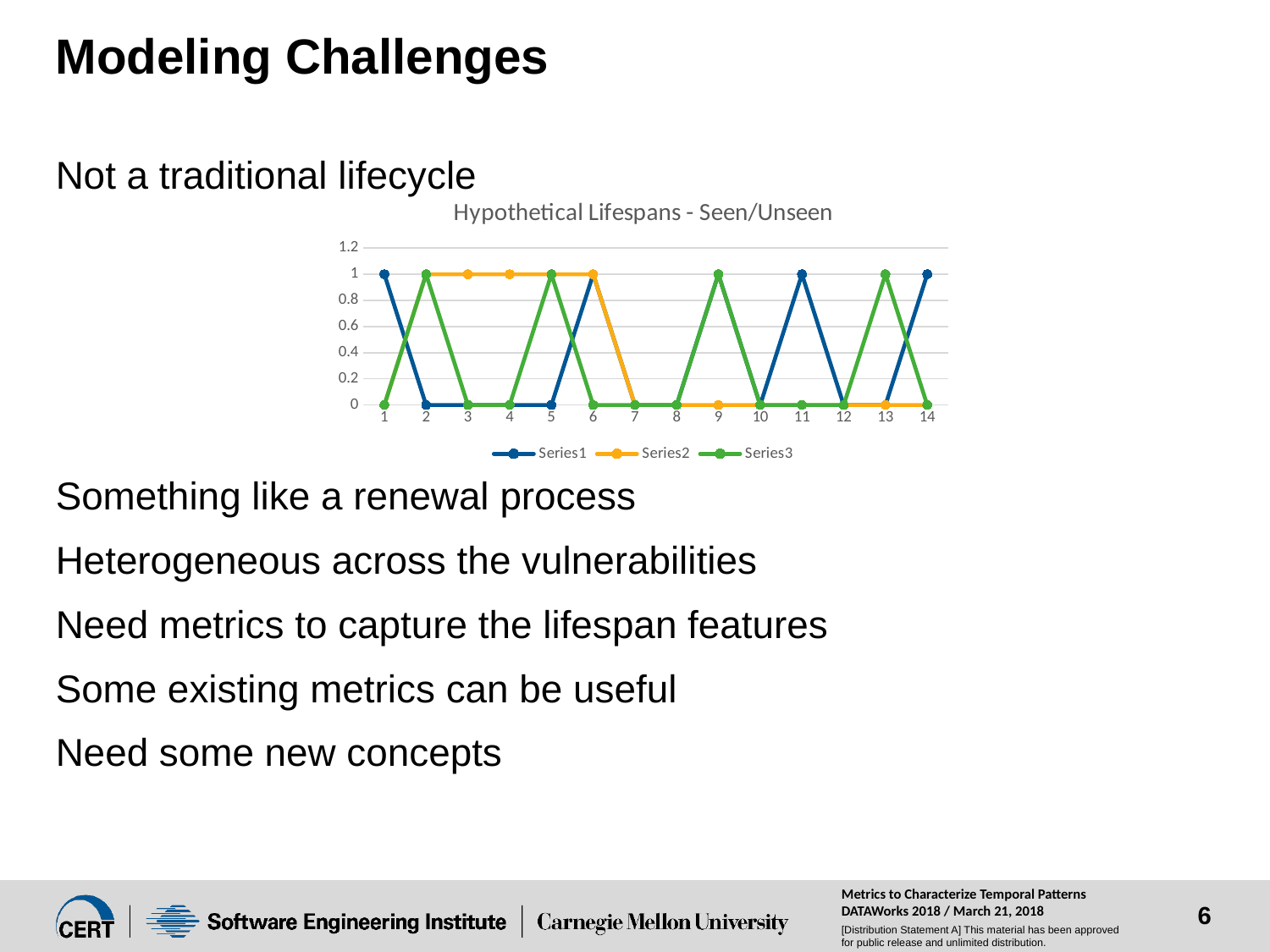
What is the value of Series2 at x = 10? 0 What is the title of the chart? Hypothetical Lifespans - Seen/Unseen What is the value of Series3 at x = 9? 1 What is the difference between Series3 and Series1 at x = 13? 1 How many series does the chart legend list? 3 Which is larger at x = 11, Series1 or Series2? Series1 What kind of chart is shown on the slide? line chart What is the value of Series2 at x = 4? 1 What is the value of Series1 at x = 1? 1 Which series is shown in green in the legend? Series3 How many points are plotted along the x axis for each series? 14 What is the value of Series1 at x = 3? 0